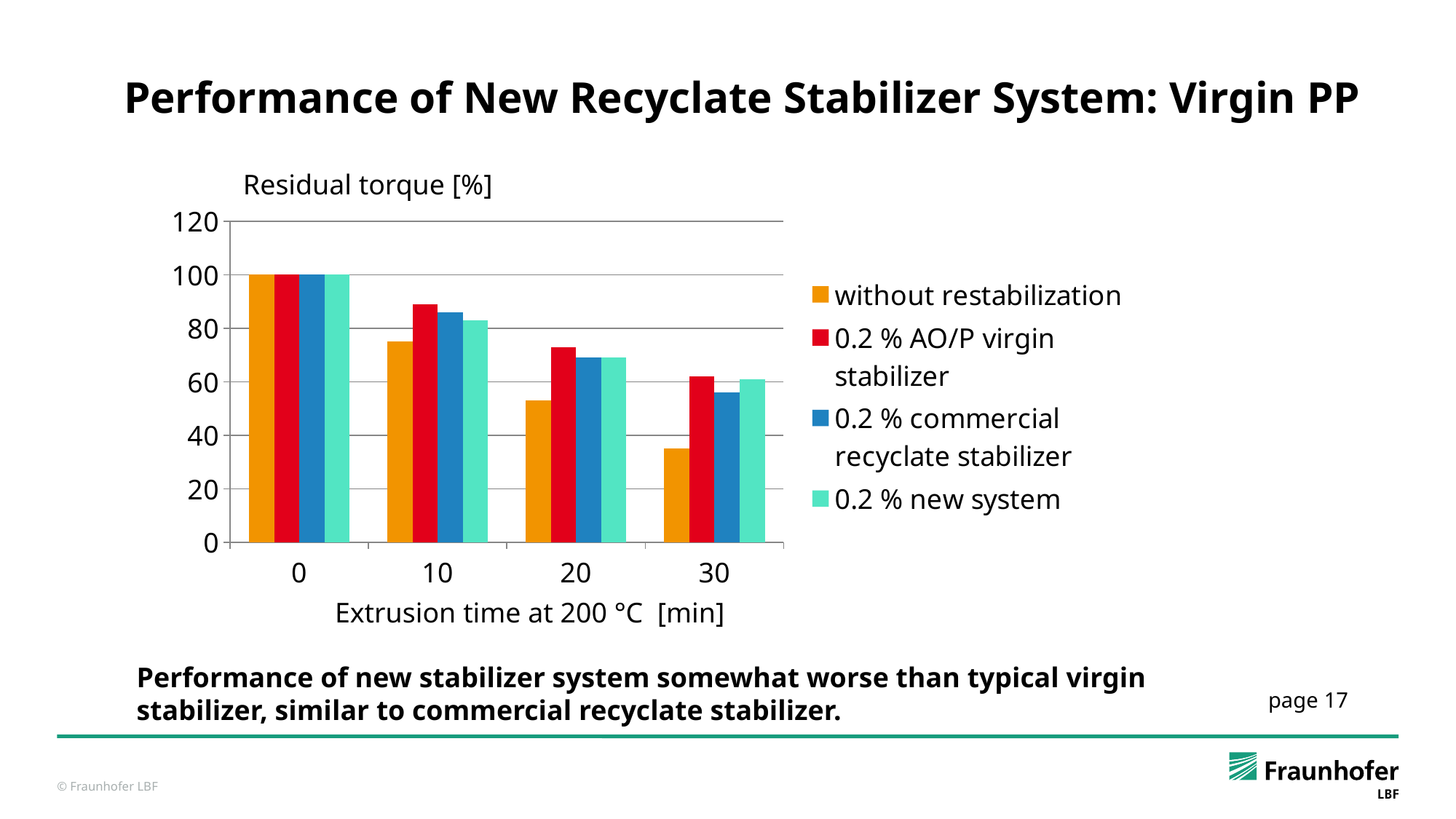
What is the residual torque for '0.2 % new system' at 0 min extrusion time? 100 Which series has the lowest residual torque at 30 min extrusion time? without restabilization What type of chart is shown on the slide? bar chart Which series has the lowest residual torque at 10 min extrusion time? without restabilization At 20 min extrusion time, which is larger: the residual torque for 'without restabilization' or for '0.2 % AO/P virgin stabilizer'? 0.2 % AO/P virgin stabilizer How many series does the legend list? 4 What is the residual torque for 'without restabilization' at 0 min extrusion time? 100 How many extrusion time categories are shown on the x axis? 4 Is the residual torque for 'without restabilization' at 20 min greater or less than 60? less Does the residual torque for 'without restabilization' rise or fall as extrusion time increases? fall Is the residual torque for '0.2 % AO/P virgin stabilizer' at 10 min greater or less than 80? greater Is the residual torque for 'without restabilization' at 30 min greater or less than 40? less